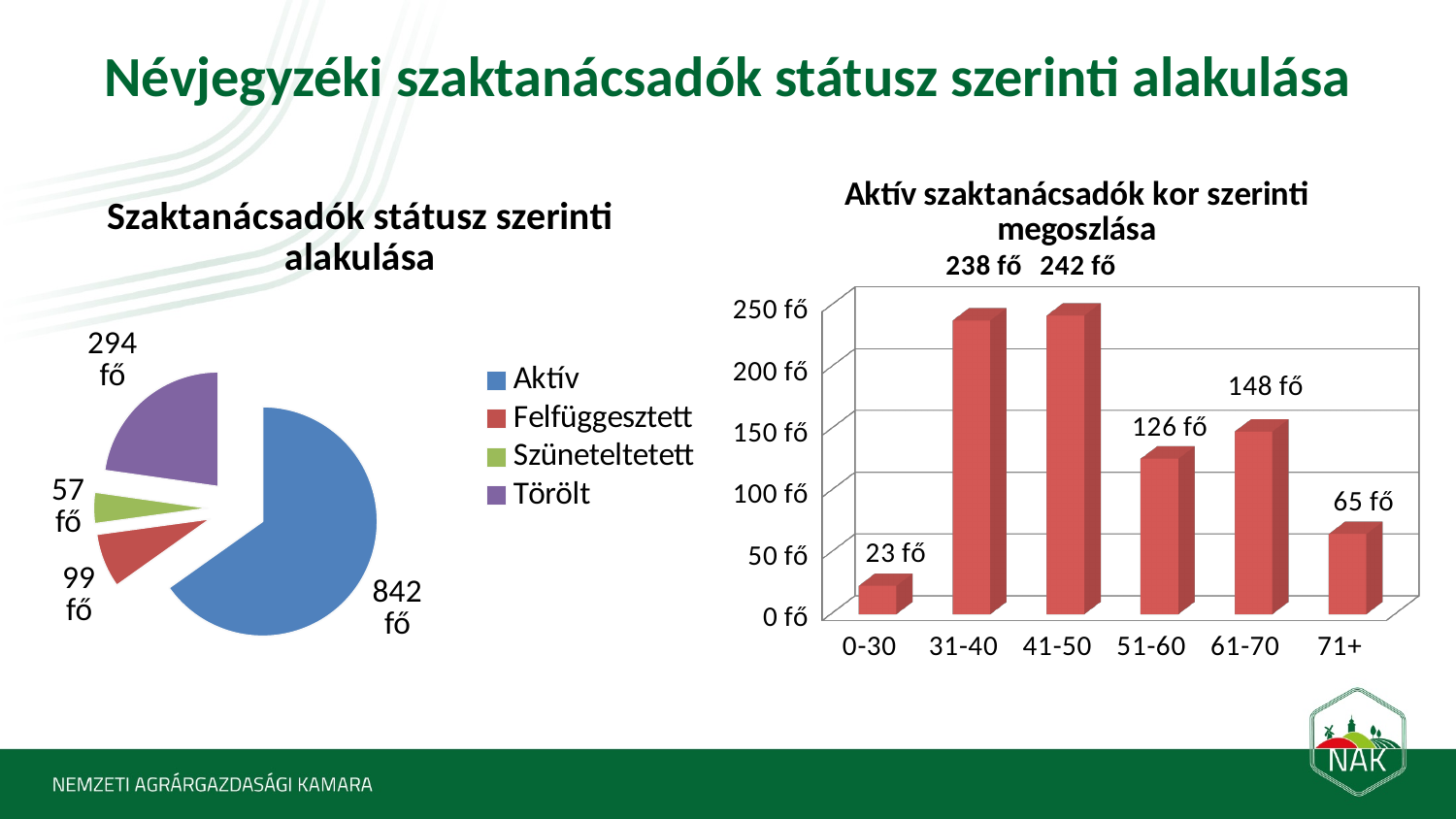
In the pie chart 'Szaktanácsadók státusz szerinti alakulása', what colour is the Törölt slice? Purple In the pie chart 'Szaktanácsadók státusz szerinti alakulása', which category has the smallest slice? Szüneteltetett In the bar chart 'Aktív szaktanácsadók kor szerinti megoszlása', which age group has the highest value? 41-50 In the pie chart 'Szaktanácsadók státusz szerinti alakulása', what is the value for Aktív? 842 fő In the bar chart 'Aktív szaktanácsadók kor szerinti megoszlása', what is the value for the 51-60 age group? 126 fő In the pie chart 'Szaktanácsadók státusz szerinti alakulása', what is the difference between Felfüggesztett and Szüneteltetett? 42 fő In the bar chart 'Aktív szaktanácsadók kor szerinti megoszlása', what is the difference between the 61-70 and 71+ age groups? 83 fő In the bar chart 'Aktív szaktanácsadók kor szerinti megoszlása', which age group has the lowest value? 0-30 In the pie chart 'Szaktanácsadók státusz szerinti alakulása', what is the value for Törölt? 294 fő What kind of chart is 'Aktív szaktanácsadók kor szerinti megoszlása'? Bar chart In the pie chart 'Szaktanácsadók státusz szerinti alakulása', how many categories does the legend list? 4 In the bar chart 'Aktív szaktanácsadók kor szerinti megoszlása', how many age groups are shown on the x axis? 6